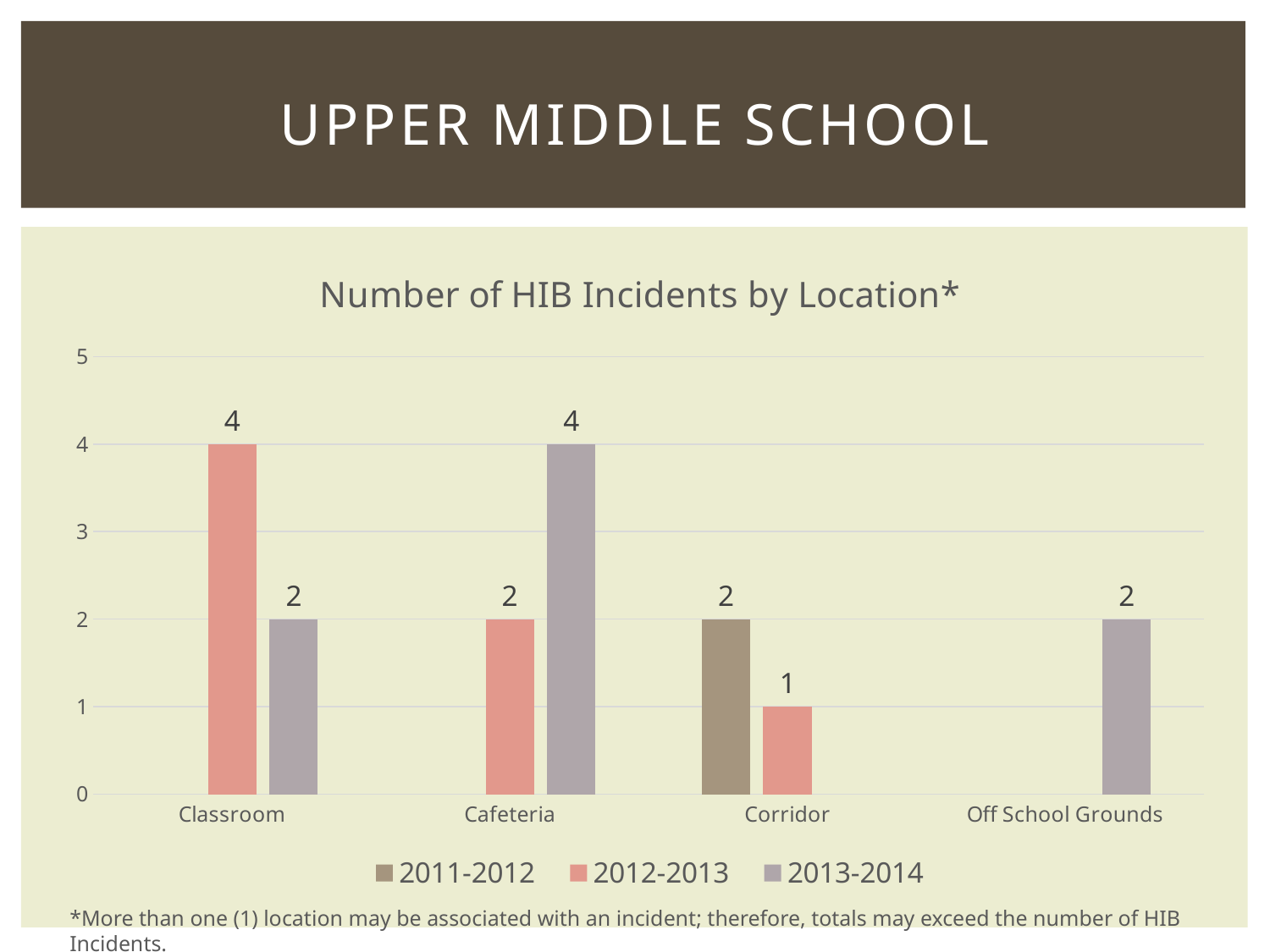
What is the value for Off School Grounds in the 2013-2014 series? 2 Which location has the lowest value in the 2012-2013 series? Corridor Which is larger for Cafeteria: the 2012-2013 value or the 2013-2014 value? 2013-2014 Which location has the highest value in the 2013-2014 series? Cafeteria What is the value for Cafeteria in the 2013-2014 series? 4 How many locations are shown on the x axis? 4 What is the title of the chart? Number of HIB Incidents by Location* What is the value for Classroom in the 2012-2013 series? 4 What is the value for Corridor in the 2011-2012 series? 2 How many series does the legend list? 3 What kind of chart is shown on the slide? Bar chart What is the difference between the 2012-2013 and 2013-2014 values for Classroom? 2